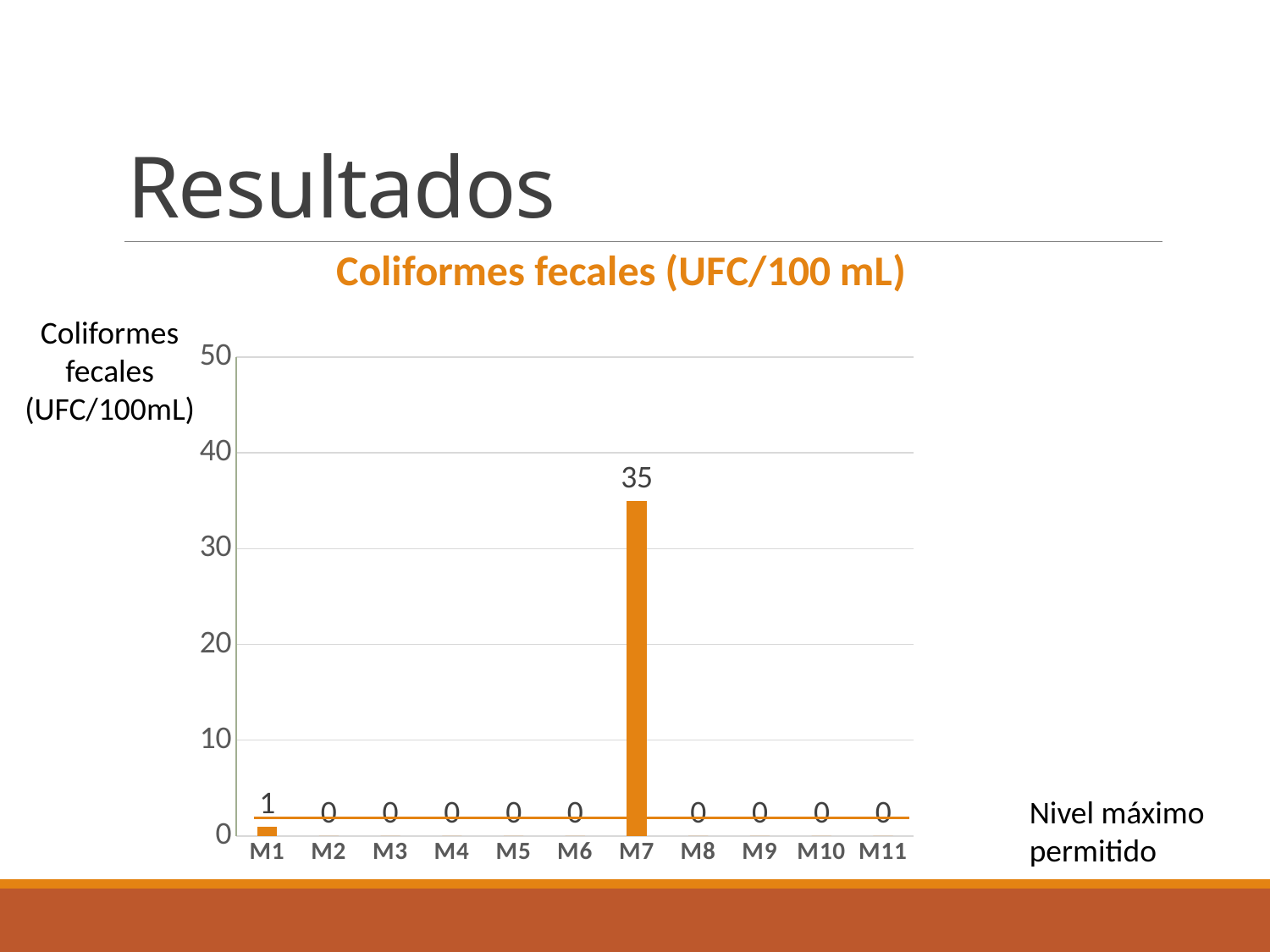
What is the difference between the values for M7 and M1? 34 What is the value for M7 in the Coliformes fecales chart? 35 What is the value for M1 in the Coliformes fecales chart? 1 What does the horizontal line across the chart represent, according to the label on the slide? Nivel máximo permitido Which is larger, the value for M1 or the value for M7? M7 How many categories have a value of 0 in the chart? 9 What kind of chart is shown on the slide? bar chart Is the value for M7 greater or less than 30? greater What is the title of the chart? Coliformes fecales (UFC/100 mL) Which category has the highest value in the Coliformes fecales chart? M7 How many categories are shown on the x axis of the chart? 11 What is the value for M4 in the Coliformes fecales chart? 0